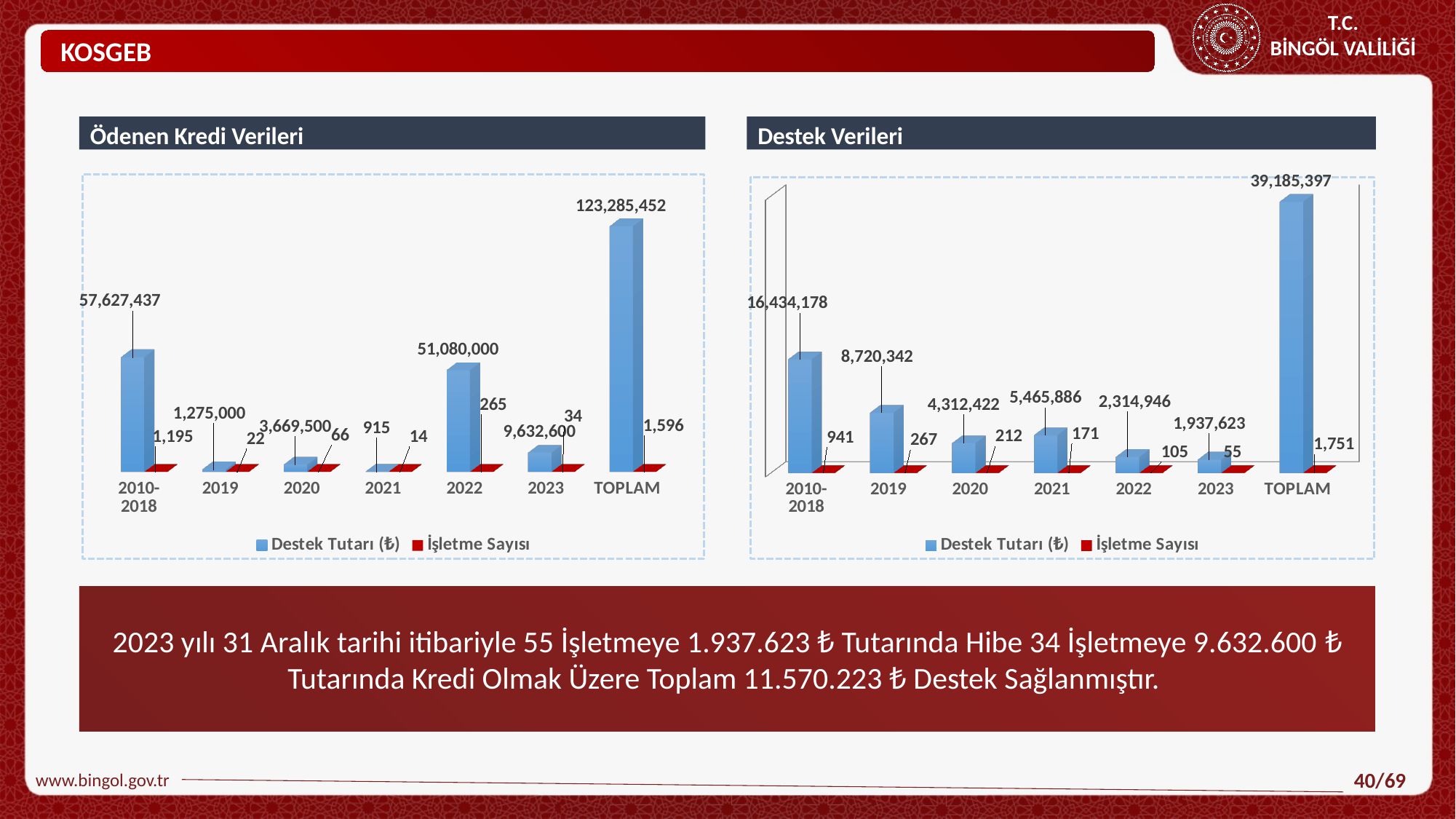
In the 'Destek Verileri' chart, which is larger, the Destek Tutarı (₺) for 2020 or for 2021? 2021 In the 'Ödenen Kredi Verileri' chart, what is the difference in İşletme Sayısı between 2022 and 2023? 231 In the 'Destek Verileri' chart, what is the difference in İşletme Sayısı between 2019 and 2020? 55 In the 'Destek Verileri' chart, what is the İşletme Sayısı value for TOPLAM? 1,751 In the 'Ödenen Kredi Verileri' chart, what is the Destek Tutarı (₺) value for TOPLAM? 123,285,452 In the 'Ödenen Kredi Verileri' chart, what is the İşletme Sayısı value for 2010-2018? 1,195 How many series does the legend of the 'Destek Verileri' chart list? 2 In the 'Ödenen Kredi Verileri' chart, excluding TOPLAM, which category has the lowest Destek Tutarı (₺)? 2021 In the 'Destek Verileri' chart, what is the Destek Tutarı (₺) value for 2019? 8,720,342 What kind of chart is the 'Ödenen Kredi Verileri' chart? Bar chart In the 'Destek Verileri' chart, excluding TOPLAM, which category has the highest Destek Tutarı (₺)? 2010-2018 In the 'Ödenen Kredi Verileri' chart, what is the Destek Tutarı (₺) value for 2022? 51,080,000